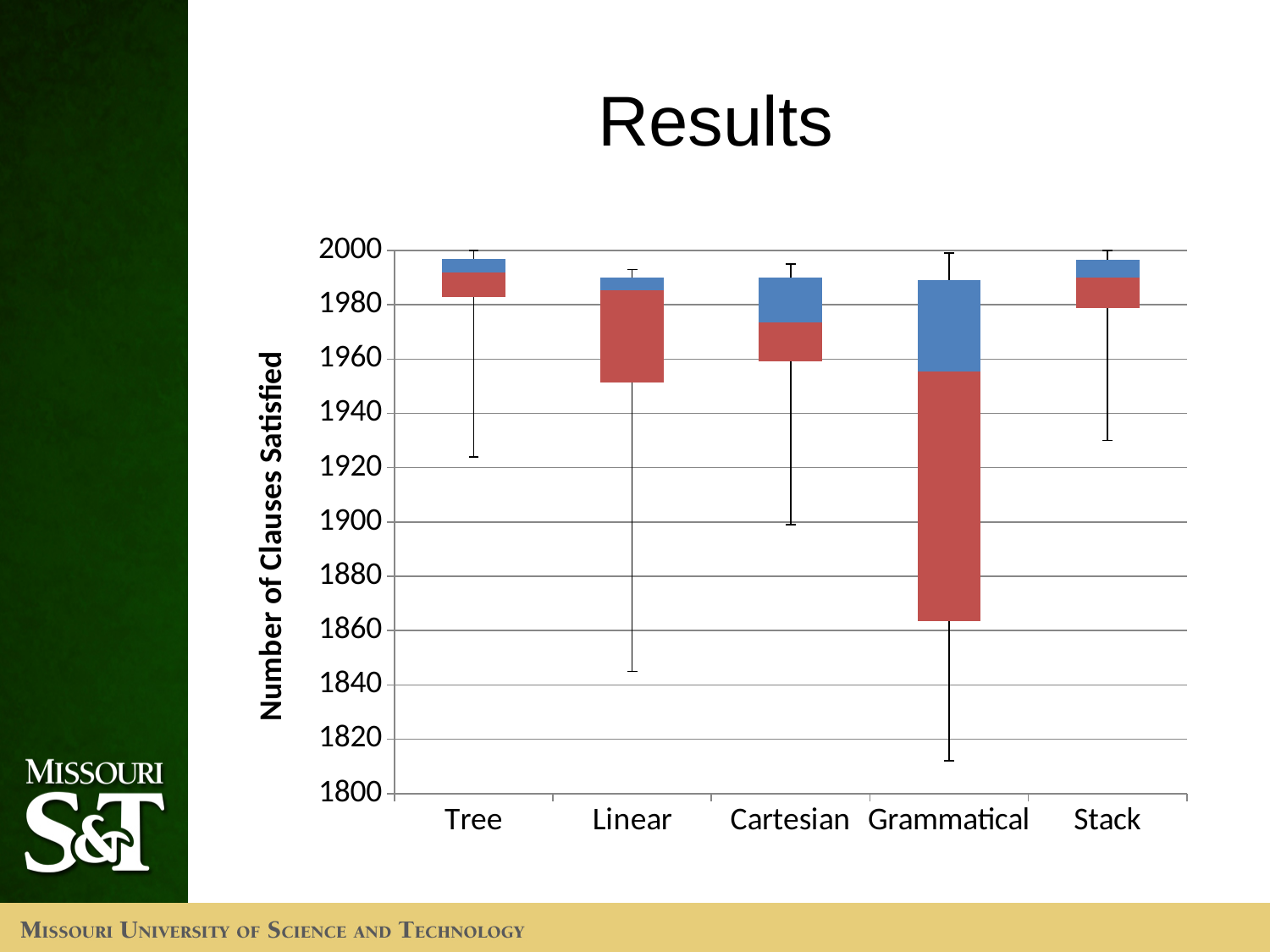
Is the bottom of the box for Linear greater or less than 1940? greater How many categories are shown along the x axis of the chart? 5 Is the bottom of the box for Grammatical greater or less than 1860? greater Which category has the lowest bottom whisker value? Grammatical Is the lower whisker for Tree greater or less than 1900? greater What is the title of the slide containing the chart? Results What is the title of the y axis? Number of Clauses Satisfied What kind of chart is shown on the slide? Box-and-whisker plot Which has a lower bottom whisker, Linear or Stack? Linear Which category has the largest box (widest interquartile range)? Grammatical